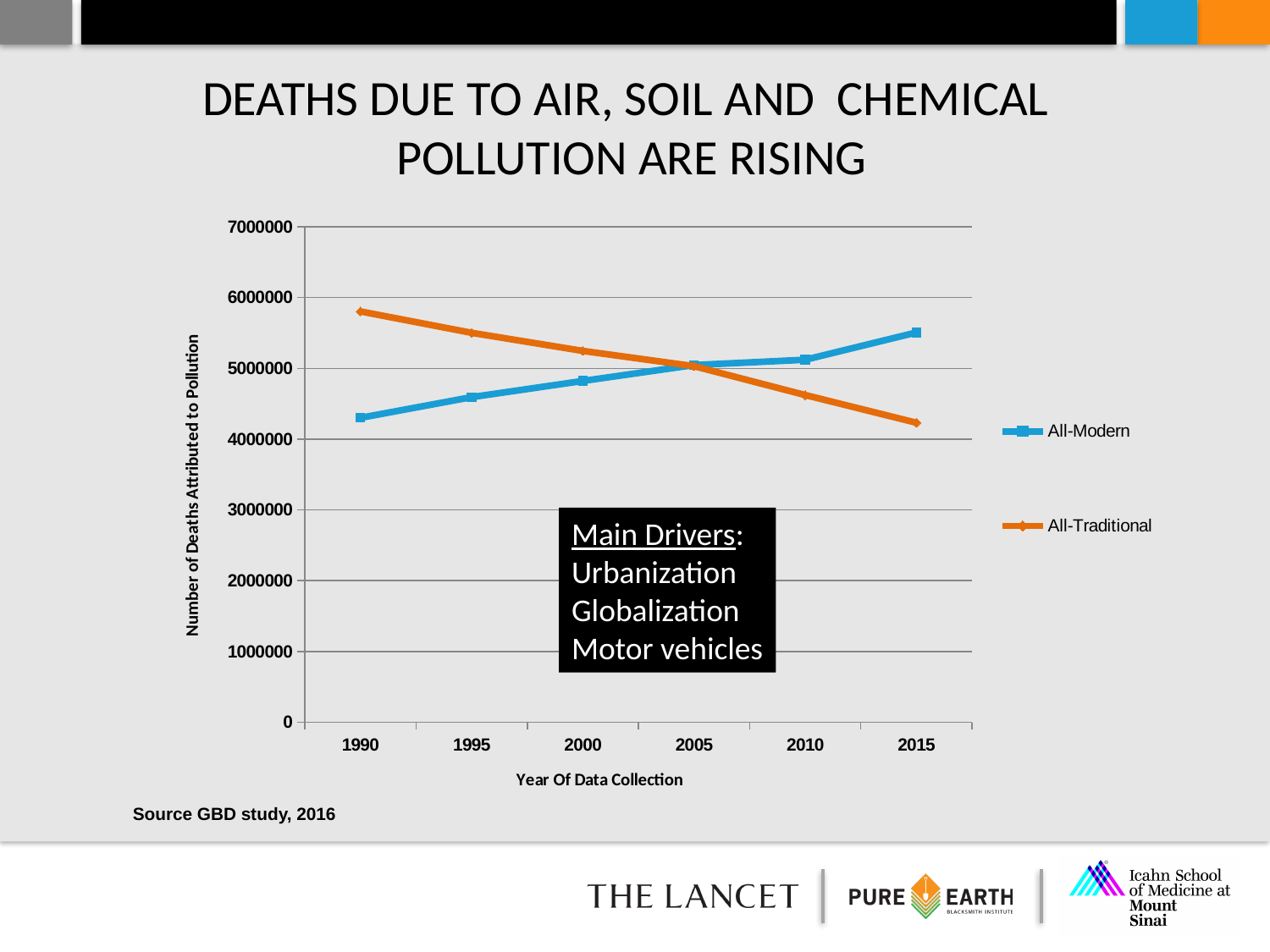
Is the All-Modern value for 1990 greater or less than 5000000? less Is the All-Modern value for 2015 greater or less than 5000000? greater In 1990, which series has the higher value, All-Modern or All-Traditional? All-Traditional Is the All-Traditional value for 2015 greater or less than 5000000? less Does the All-Modern series rise or fall from 1990 to 2015? rise What kind of chart is shown on the slide? line chart How many years are plotted along the x axis? 6 How many series does the legend list? 2 What is the title of the x axis? Year Of Data Collection In which year is the All-Traditional series at its highest? 1990 Does the All-Traditional series rise or fall from 1990 to 2015? fall